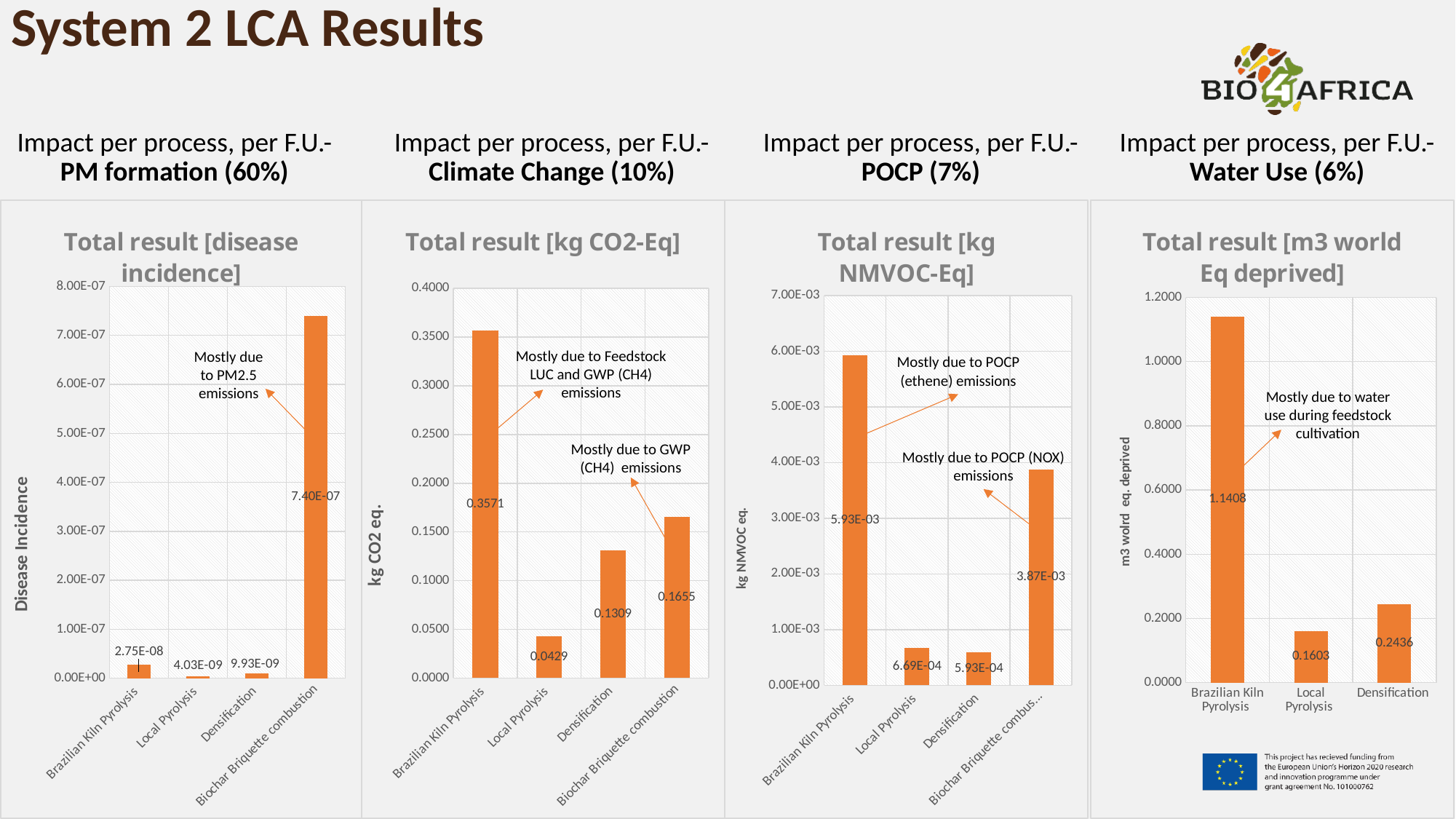
In the PM formation chart, what is the value for Biochar Briquette combustion? 7.40E-07 What type of chart is the POCP chart? Bar chart In the POCP chart, which is larger: the value for Brazilian Kiln Pyrolysis or the value for Biochar Briquette combustion? Brazilian Kiln Pyrolysis In the Water Use chart, what is the value for Densification? 0.2436 In the Climate Change chart, which category has the lowest value? Local Pyrolysis In the PM formation chart, which category has the highest value? Biochar Briquette combustion In the Climate Change chart, what is the value for Brazilian Kiln Pyrolysis? 0.3571 How many categories are shown in the Water Use chart? 3 In the Climate Change chart, what is the difference between the values for Biochar Briquette combustion and Densification? 0.0346 In the POCP chart, what is the value for Local Pyrolysis? 6.69E-04 In the Water Use chart, what is the difference between the values for Brazilian Kiln Pyrolysis and Local Pyrolysis? 0.9805 In the Water Use chart, which category has the highest value? Brazilian Kiln Pyrolysis